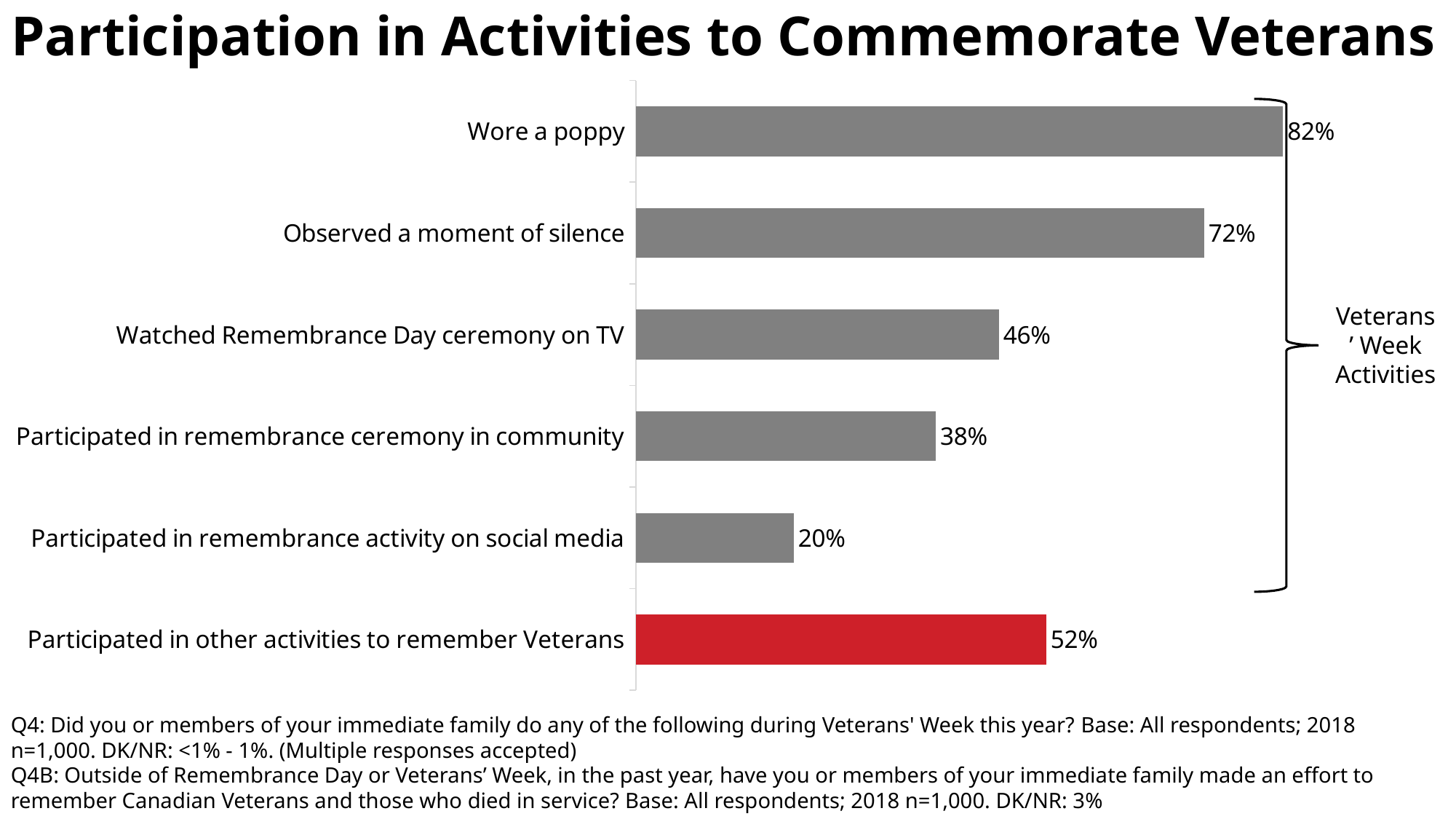
What percentage of respondents wore a poppy? 82% What type of chart is shown on the slide? Bar chart What is the difference between 'Watched Remembrance Day ceremony on TV' and 'Participated in remembrance ceremony in community'? 8% Which activity has the lowest participation percentage? Participated in remembrance activity on social media What is the value for 'Participated in other activities to remember Veterans'? 52% What is the difference between 'Wore a poppy' and 'Observed a moment of silence'? 10% Which is larger: 'Watched Remembrance Day ceremony on TV' or 'Participated in other activities to remember Veterans'? Participated in other activities to remember Veterans Which activity has the highest participation percentage? Wore a poppy How many activity categories are shown in the chart? 6 Which bar is coloured red rather than grey? Participated in other activities to remember Veterans What is the value for 'Observed a moment of silence'? 72% What percentage participated in a remembrance activity on social media? 20%